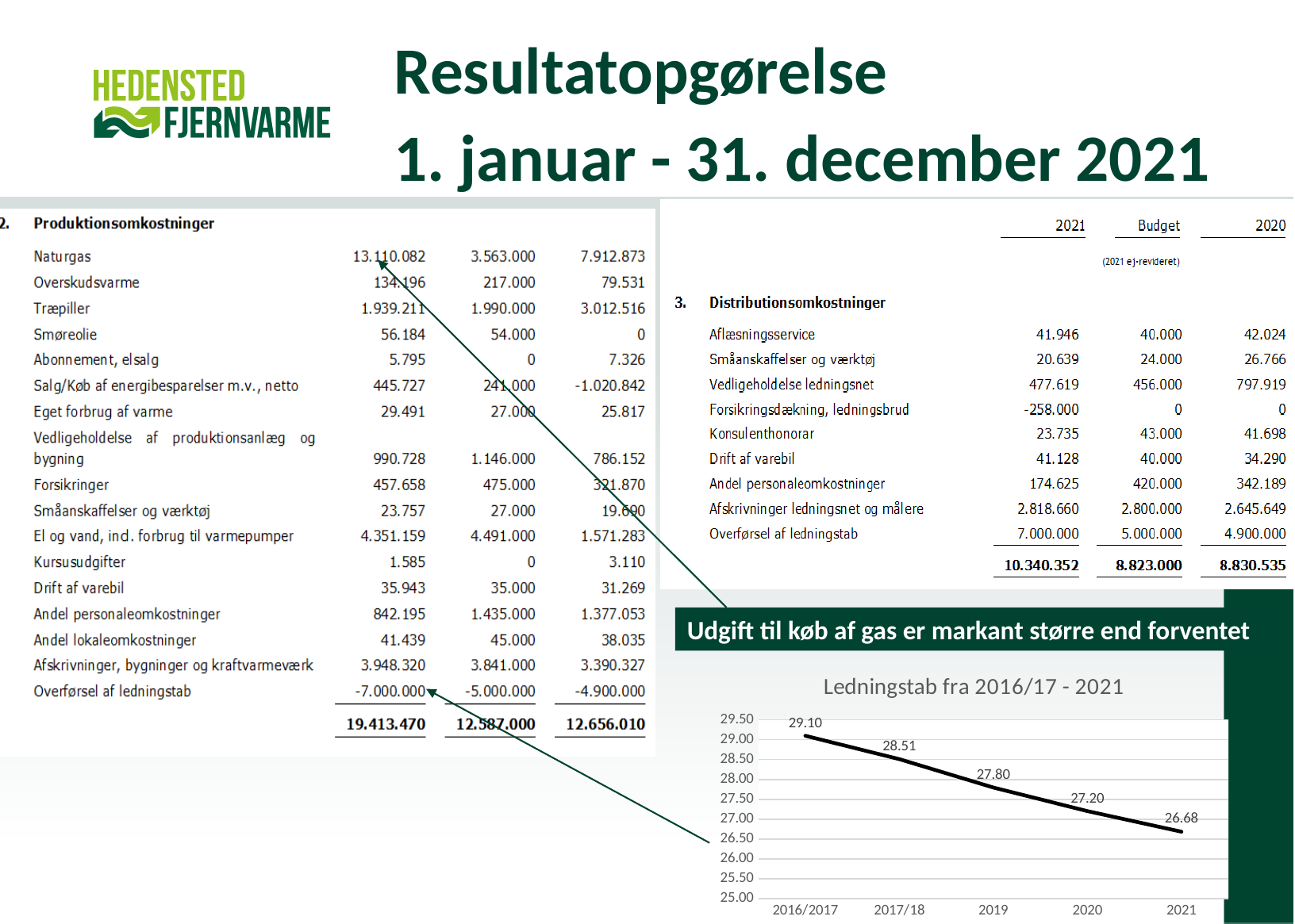
In the chart "Ledningstab fra 2016/17 - 2021", which period has the highest value? 2016/2017 In the chart "Ledningstab fra 2016/17 - 2021", what is the value for 2019? 27.80 How many data points are plotted in the chart "Ledningstab fra 2016/17 - 2021"? 5 In the chart "Ledningstab fra 2016/17 - 2021", do the values rise or fall from 2016/2017 to 2021? fall What type of chart is "Ledningstab fra 2016/17 - 2021"? line chart In the chart "Ledningstab fra 2016/17 - 2021", what is the value for 2017/18? 28.51 In the chart "Ledningstab fra 2016/17 - 2021", what is the value for 2021? 26.68 In the chart "Ledningstab fra 2016/17 - 2021", what is the value for 2016/2017? 29.10 In the chart "Ledningstab fra 2016/17 - 2021", which year has the lowest value? 2021 In the chart "Ledningstab fra 2016/17 - 2021", is the value for 2020 greater or less than 27.00? greater In the chart "Ledningstab fra 2016/17 - 2021", which is larger, the value for 2019 or the value for 2020? 2019 In the chart "Ledningstab fra 2016/17 - 2021", what is the difference between the 2016/2017 value and the 2021 value? 2.42